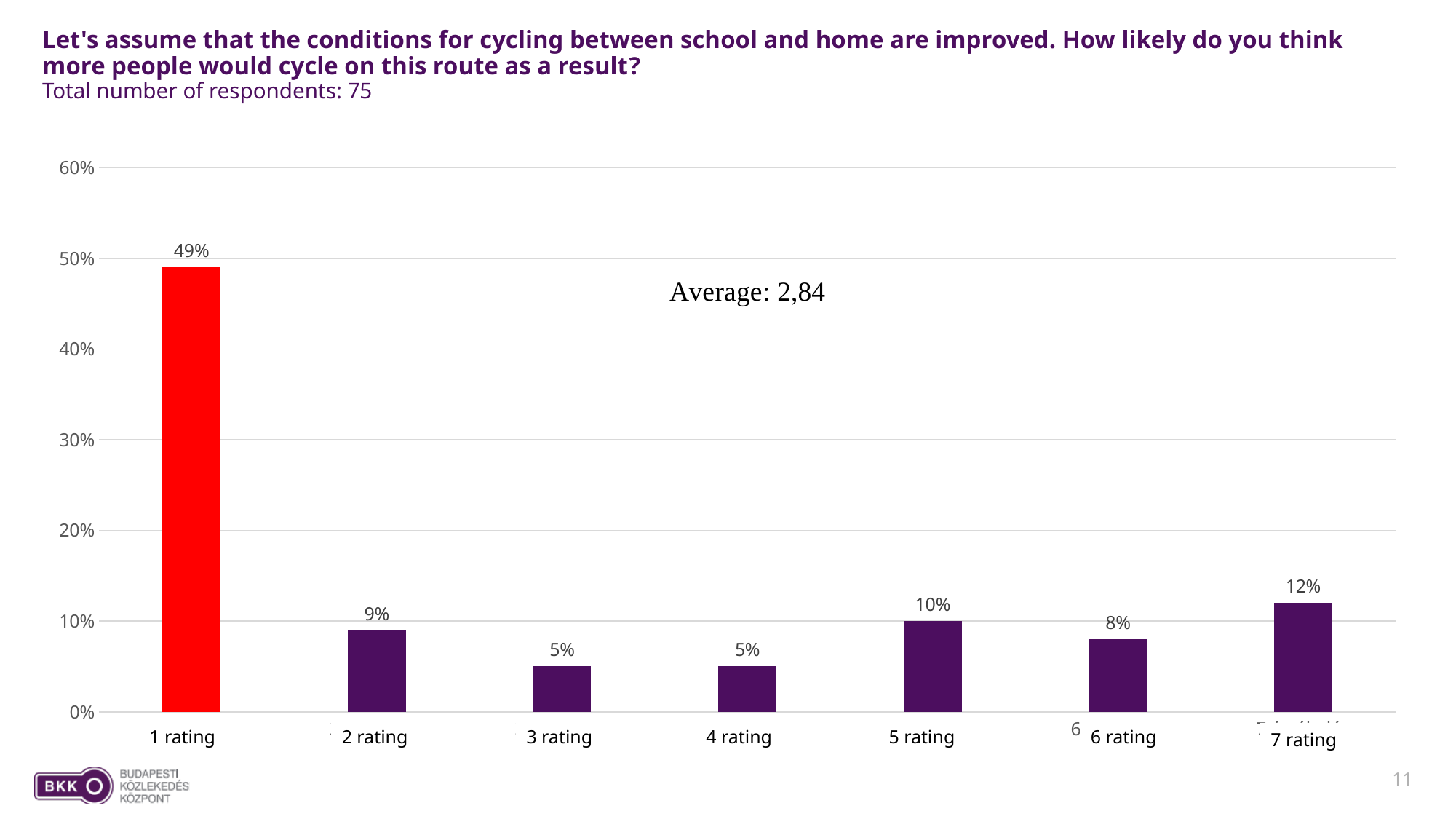
Which is larger, the share for 6 rating or the share for 7 rating? 7 rating What percentage of respondents gave a 7 rating? 12% How many rating categories are shown on the chart? 7 What kind of chart is shown on the slide? Bar chart What is the combined percentage for the 3 rating and 4 rating bars? 10% What is the total number of respondents stated on the slide? 75 What is the average rating stated on the chart? 2,84 What percentage of respondents gave a 1 rating? 49% Is the value for 1 rating greater or less than 40%? greater What is the difference in percentage points between the 1 rating and the 2 rating? 40% What percentage of respondents gave a 5 rating? 10% Which rating has the highest share of respondents? 1 rating